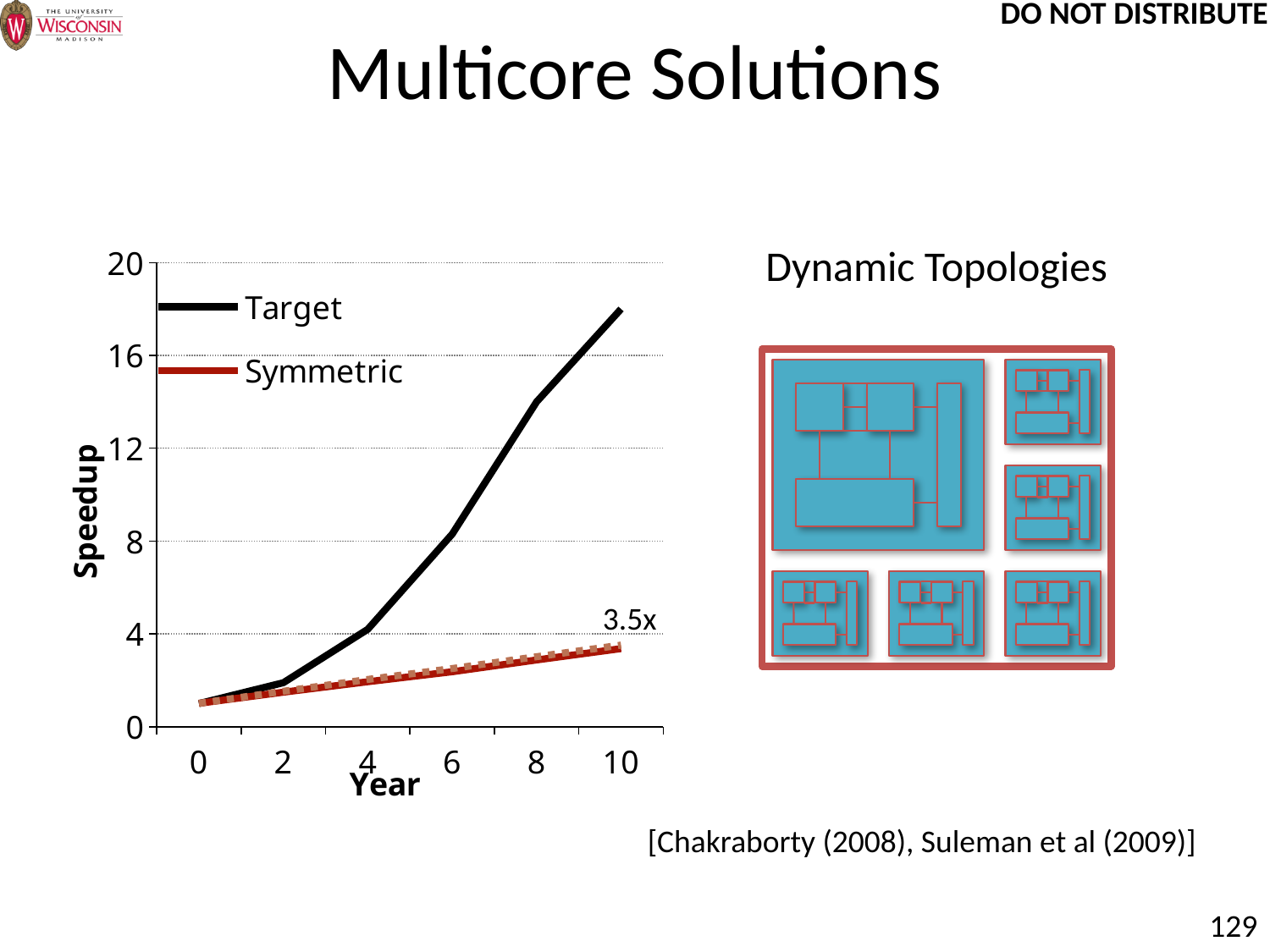
Does the Target speedup rise or fall as the year increases from 0 to 10? rise Is the Symmetric speedup at year 10 greater or less than 4? less Is the Target speedup at year 6 greater or less than 12? less What are the two series named in the chart legend? Target and Symmetric At year 10, which series has the higher speedup, Target or Symmetric? Target Is the Target speedup at year 10 greater or less than 16? greater What is the label on the chart's y axis? Speedup How many tick labels are shown on the Year axis? 6 What value label is printed at the end of the Symmetric line at year 10? 3.5x How many series does the chart legend list? 2 What kind of chart is shown on the slide? line chart